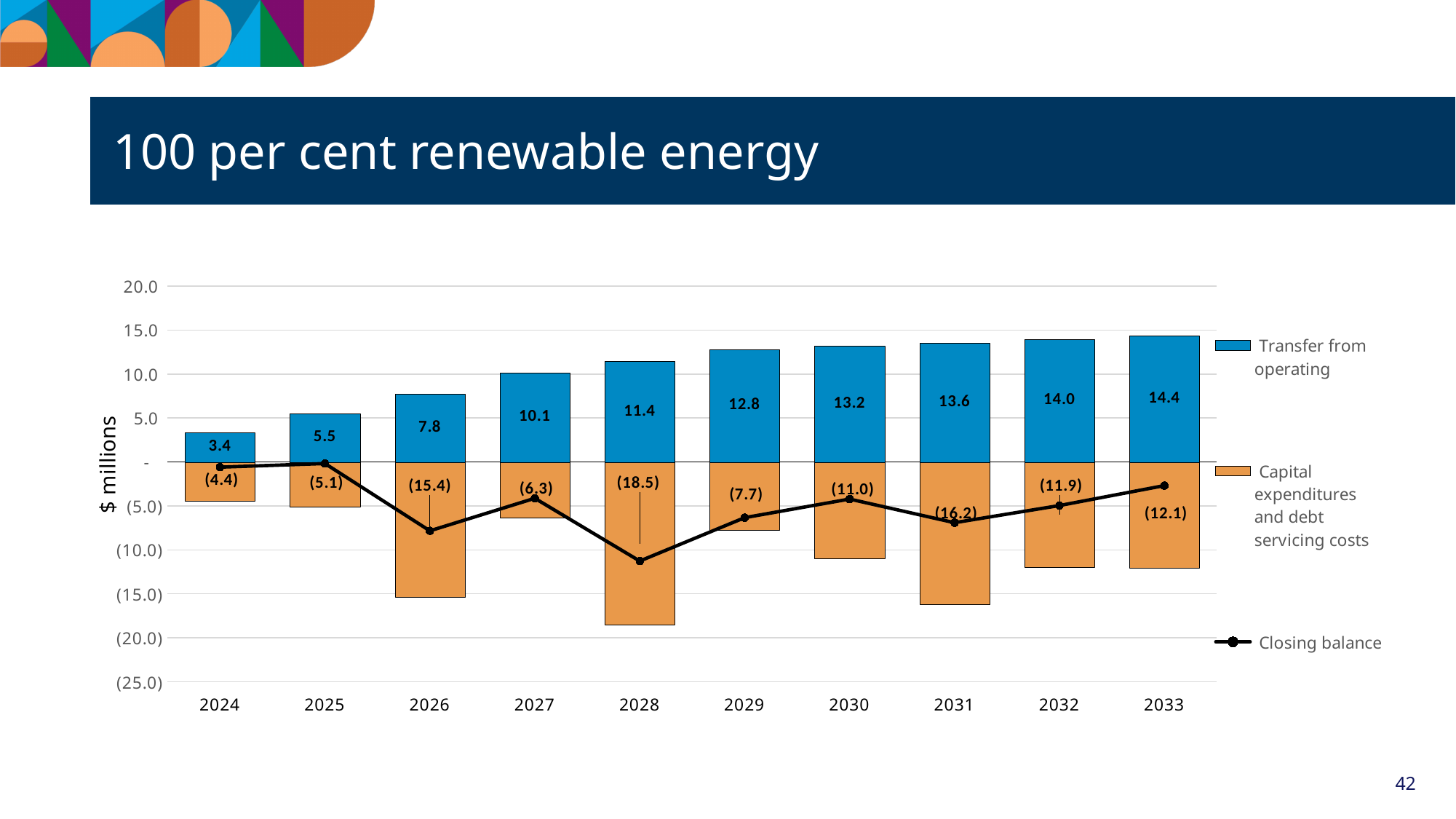
How many series does the legend list? 3 Is the Closing balance for 2028 greater or less than (10.0)? less How many years are shown on the x axis? 10 Which year has the lowest Transfer from operating value? 2024 What kind of chart is shown on the slide? Bar chart with a line Which year has the highest Transfer from operating value? 2033 What is the Capital expenditures and debt servicing costs value for 2028? (18.5) What is the difference between the Transfer from operating values for 2033 and 2024? 11.0 Does the Transfer from operating value rise or fall from 2024 to 2033? Rise Which year has the largest Capital expenditures and debt servicing costs? 2028 Which year has larger Capital expenditures and debt servicing costs, 2026 or 2031? 2031 What is the Transfer from operating value for 2027? 10.1